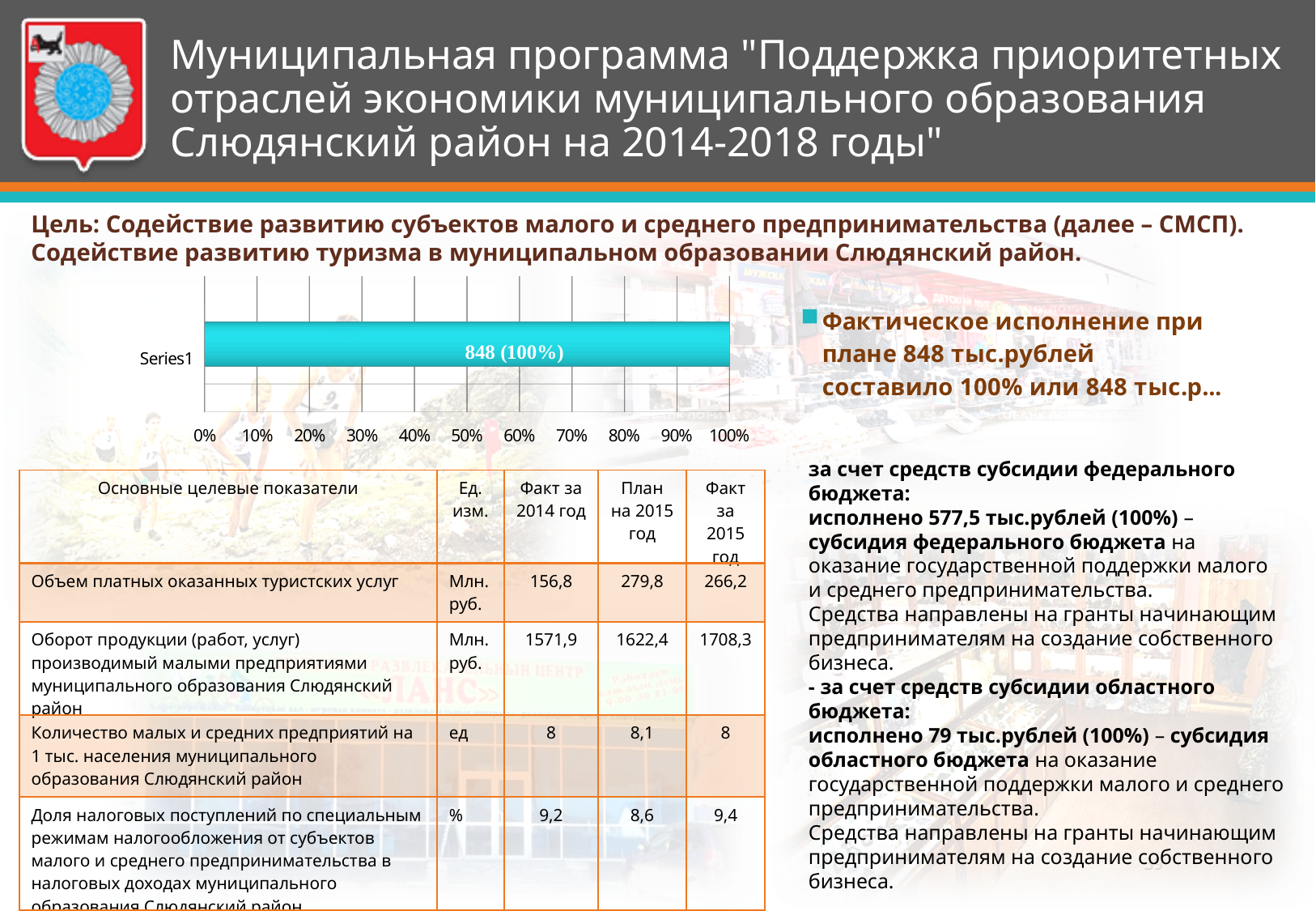
What percentage does the bar for Series1 reach according to its data label? 100% How many bars are plotted in the chart? 1 What kind of chart is shown on the slide? bar chart What data label is printed on the bar for Series1? 848 (100%) Are the bars in the chart horizontal or vertical? horizontal What is the highest tick value shown on the horizontal axis of the chart? 100% Is the value for Series1 greater or less than 90%? greater What is the label of the single category on the vertical axis of the chart? Series1